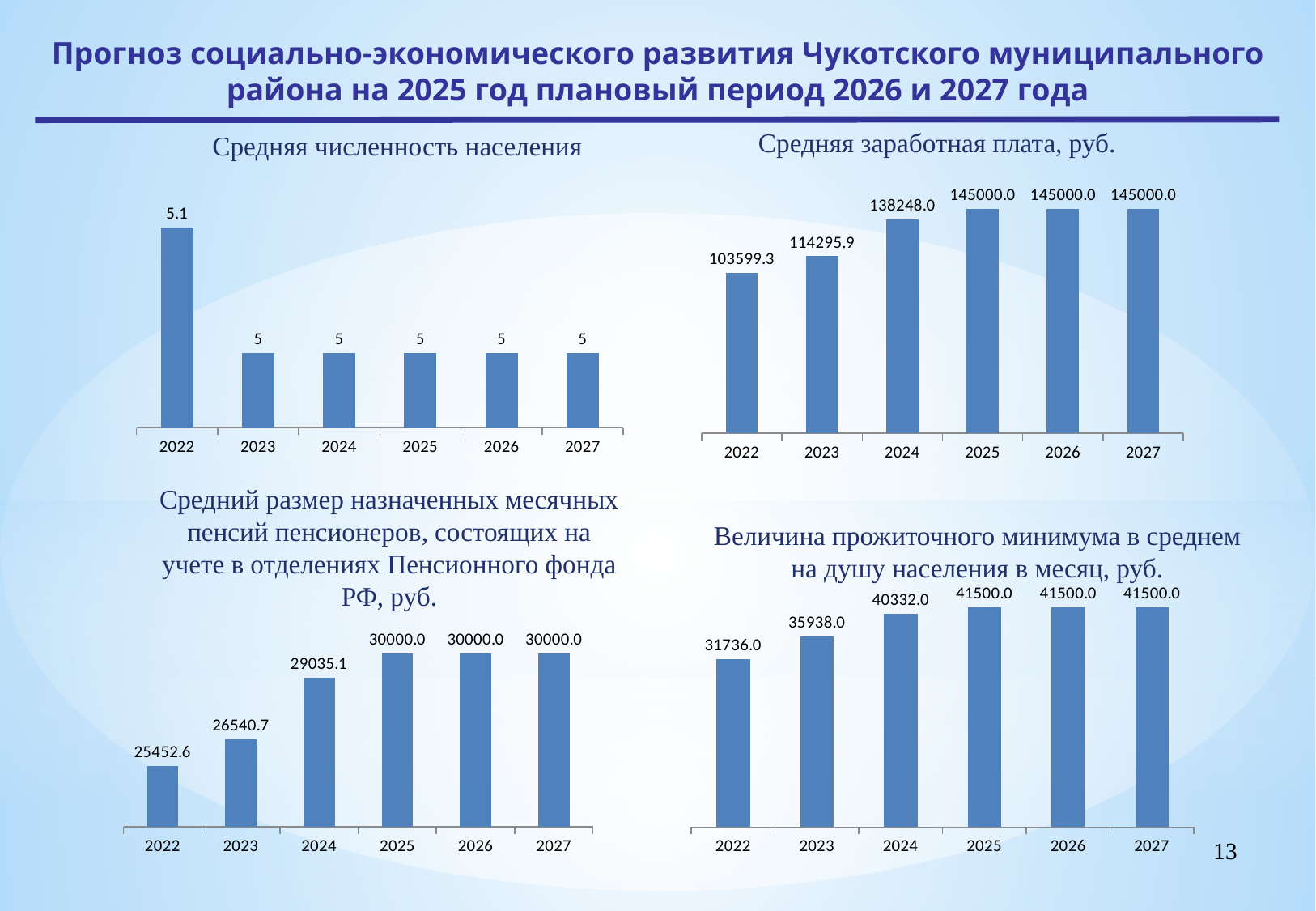
What kind of chart is 'Величина прожиточного минимума в среднем на душу населения в месяц, руб.'? bar chart In the chart 'Средняя численность населения', what is the value for 2022? 5.1 In the chart 'Величина прожиточного минимума в среднем на душу населения в месяц, руб.', which is larger, the value for 2022 or the value for 2024? 2024 In the chart 'Средняя заработная плата, руб.', which year has the lowest value? 2022 In the chart 'Средний размер назначенных месячных пенсий пенсионеров, состоящих на учете в отделениях Пенсионного фонда РФ, руб.', do the values rise or fall from 2022 to 2025? rise In the chart 'Средняя заработная плата, руб.', what is the value for 2023? 114295.9 In the chart 'Средний размер назначенных месячных пенсий пенсионеров, состоящих на учете в отделениях Пенсионного фонда РФ, руб.', what is the difference between the values for 2023 and 2022? 1088.1 In the chart 'Средний размер назначенных месячных пенсий пенсионеров, состоящих на учете в отделениях Пенсионного фонда РФ, руб.', what is the value for 2024? 29035.1 In the chart 'Средняя численность населения', which year has the highest value? 2022 In the chart 'Величина прожиточного минимума в среднем на душу населения в месяц, руб.', what is the value for 2023? 35938.0 In the chart 'Средняя заработная плата, руб.', how many years are shown on the x axis? 6 In the chart 'Средняя заработная плата, руб.', what is the difference between the values for 2024 and 2022? 34648.7